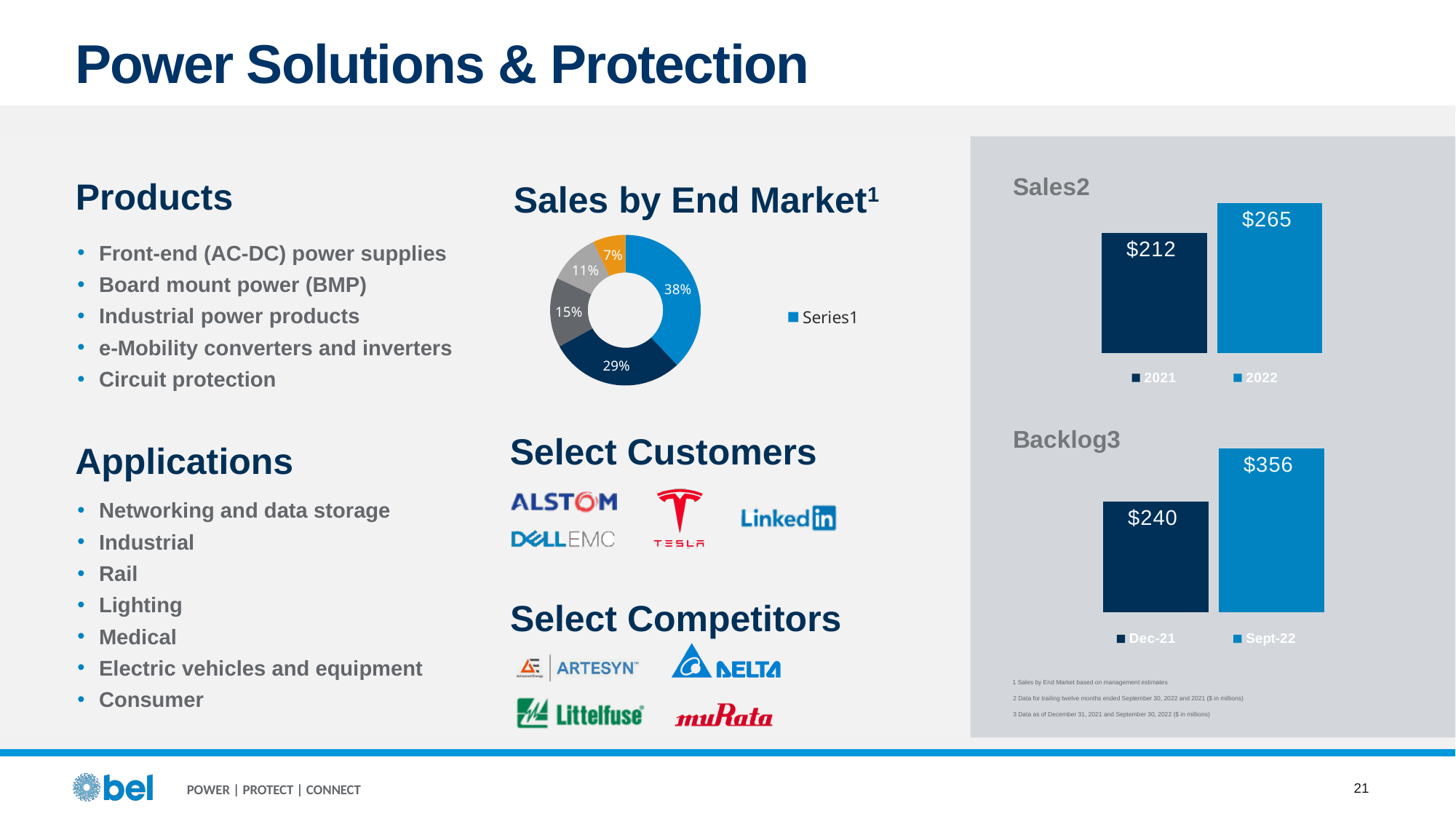
What kind of chart is the Backlog chart? Bar chart In the Backlog chart, which is larger, Dec-21 or Sept-22? Sept-22 In the Sales by End Market chart, what is the percentage of the largest slice? 38% In the Backlog chart, what is the value for Dec-21? $240 In the Sales chart, which year has the higher value? 2022 In the Backlog chart, what is the value for Sept-22? $356 In the Sales by End Market chart, what is the percentage of the smallest slice? 7% In the Backlog chart, what is the difference between the Sept-22 and Dec-21 values? $116 In the Sales chart, what is the difference between the 2022 and 2021 values? $53 In the Sales chart, what is the value for 2021? $212 How many slices does the Sales by End Market chart have? 5 In the Sales chart, what is the value for 2022? $265